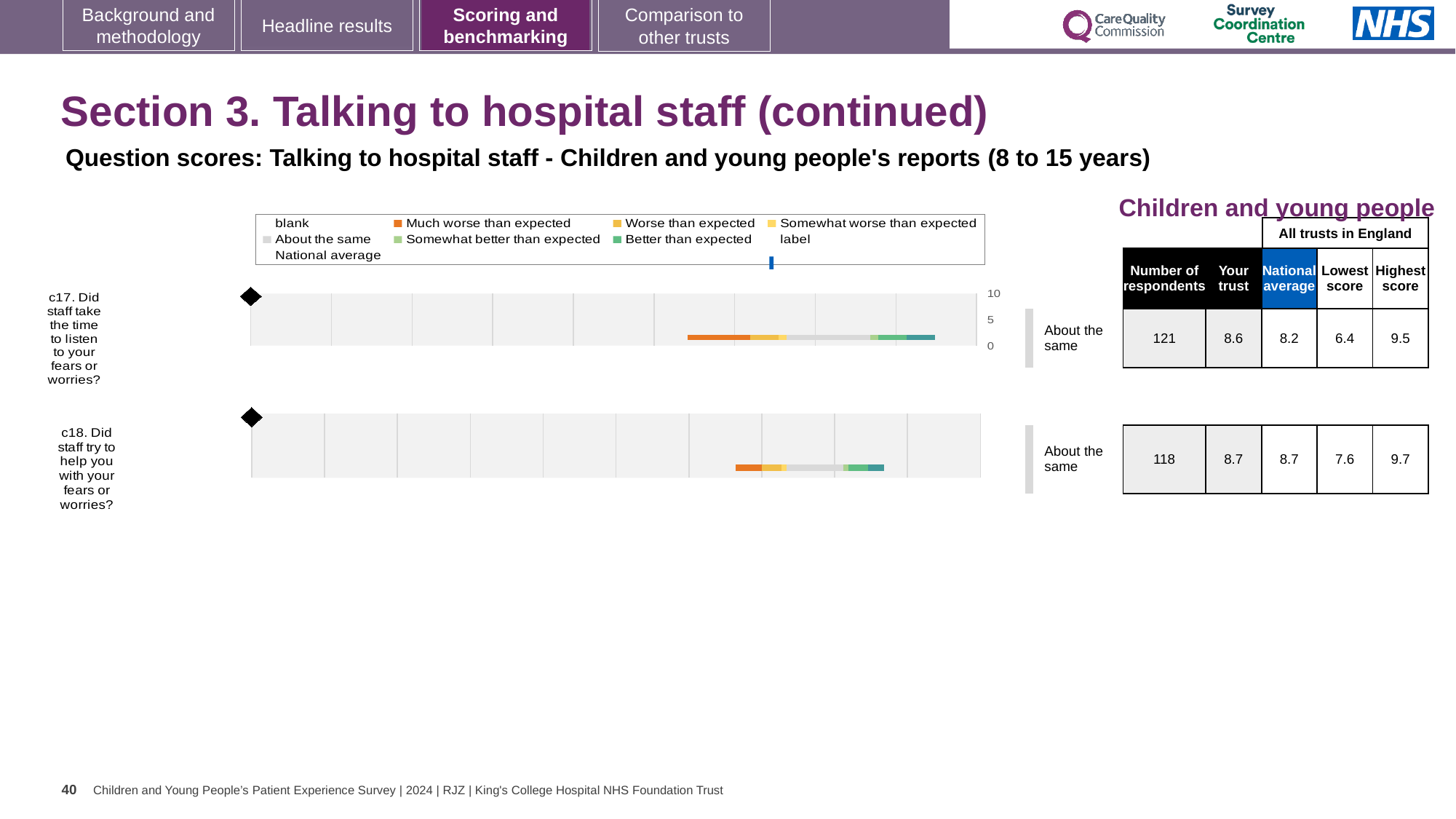
What is the lowest score across all trusts in England for c17? 6.4 How many respondents answered c17? 121 For c17, what is the difference between the 'Your trust' score and the national average? 0.4 How many questions (categories) are plotted on the slide? 2 What benchmark category label is shown next to the c18 chart? About the same What kind of chart is used to show the c17 and c18 question scores? bar chart For c18, what is the difference between the highest and lowest scores across all trusts in England? 2.1 For c17, is the 'Your trust' score higher or lower than the national average? higher According to the table, what is the national average for c18 (Did staff try to help you with your fears or worries?)? 8.7 How many respondents answered c18? 118 According to the table, what is the 'Your trust' score for c17 (Did staff take the time to listen to your fears or worries?)? 8.6 What is the highest score across all trusts in England for c18? 9.7